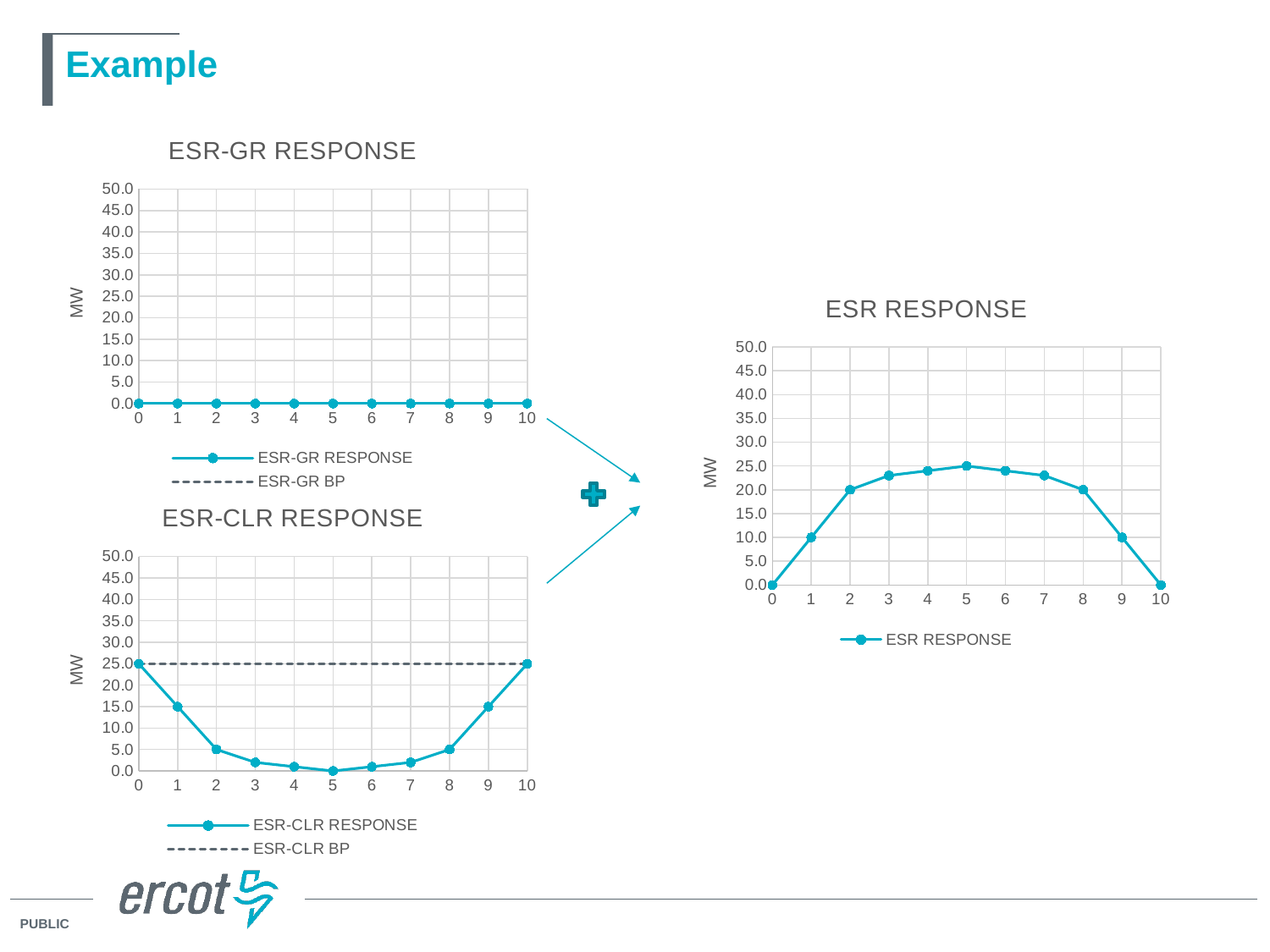
In the ESR RESPONSE chart, what is the value of ESR RESPONSE at x = 5? 25.0 In the ESR-GR RESPONSE chart, what is the value of ESR-GR RESPONSE at x = 5? 0.0 What kind of chart is the ESR RESPONSE chart on the right of the slide? line chart In the ESR RESPONSE chart, is the value of ESR RESPONSE at x = 3 greater or less than 20.0? greater In the ESR-CLR RESPONSE chart, what constant value does the ESR-CLR BP dashed line sit at? 25.0 How many series does the legend of the ESR-CLR RESPONSE chart list? 2 How many series does the legend of the ESR RESPONSE chart list? 1 In the ESR RESPONSE chart, at which x value is ESR RESPONSE highest? 5 In the ESR-CLR RESPONSE chart, what is the value of ESR-CLR RESPONSE at x = 5? 0.0 In the ESR-CLR RESPONSE chart, what is the value of ESR-CLR RESPONSE at x = 0? 25.0 In the ESR-CLR RESPONSE chart, does the ESR-CLR RESPONSE line rise or fall from x = 0 to x = 5? fall How many data points are plotted on the ESR RESPONSE line in the ESR RESPONSE chart? 11